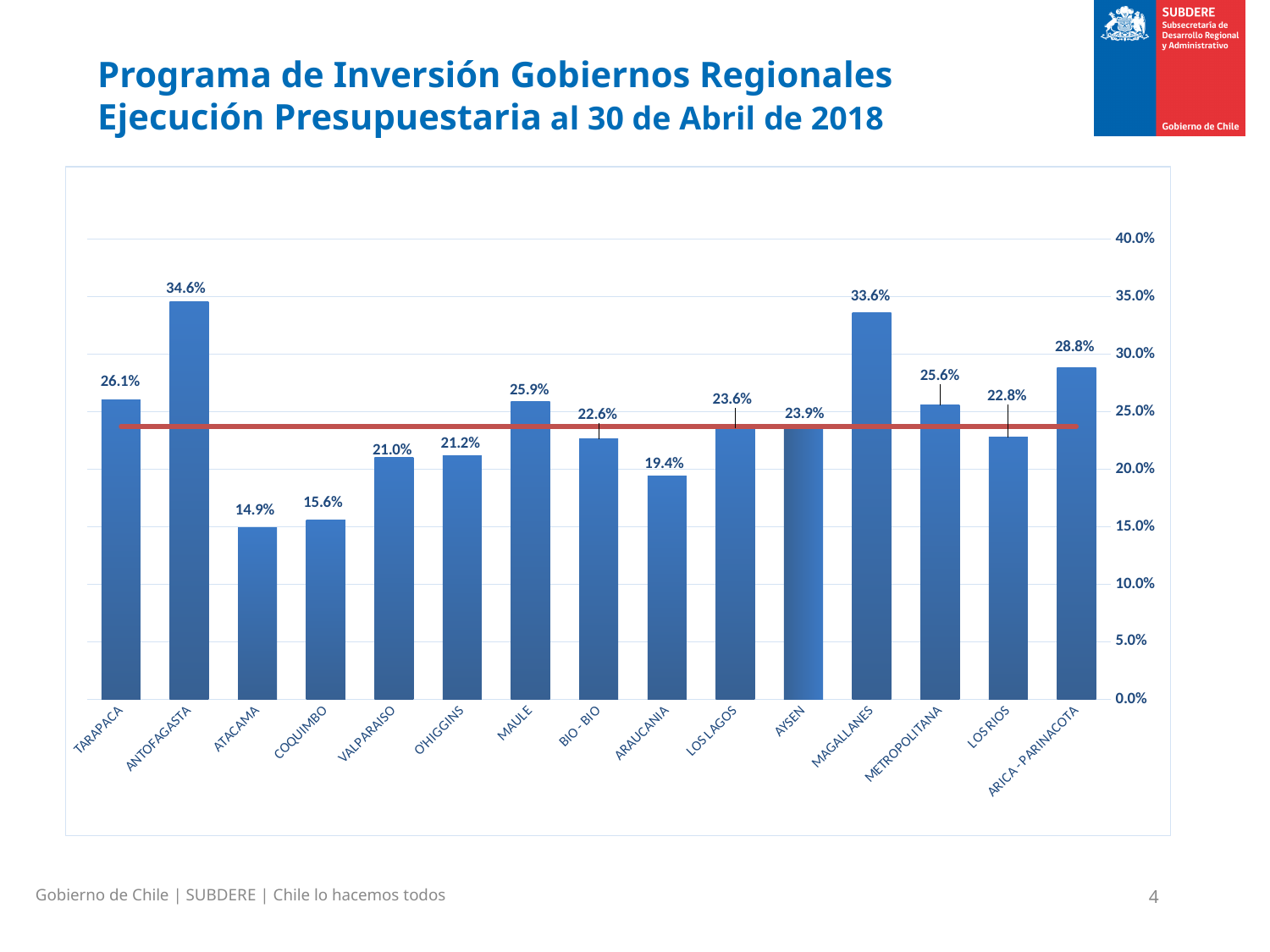
What is the difference between the values for COQUIMBO and ATACAMA? 0.7 percentage points Which region has the lowest value? ATACAMA What is the value for ANTOFAGASTA? 34.6% Which region has the highest value? ANTOFAGASTA What is the value for MAGALLANES? 33.6% How many regions are shown on the x axis of the chart? 15 What is the value for ARAUCANIA? 19.4% What is the difference between the values for ANTOFAGASTA and MAGALLANES? 1.0 percentage points What is the value for ARICA - PARINACOTA? 28.8% What type of chart is shown on the slide? combination bar and line chart Is the value for ARAUCANIA greater or less than 20.0%? less Which has a larger value, MAULE or METROPOLITANA? MAULE